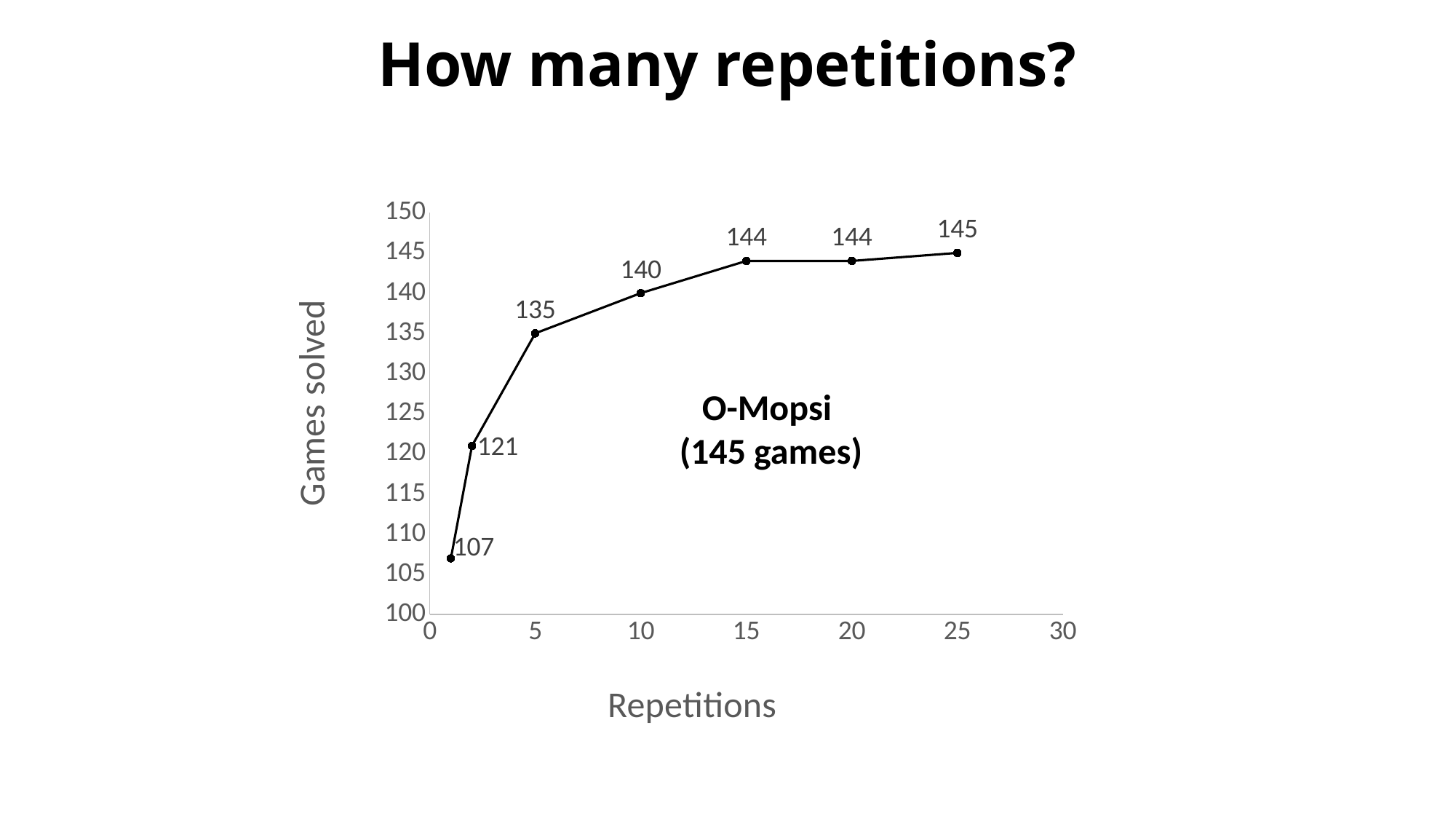
How many data points are plotted on the chart? 7 How many games were solved at 5 repetitions? 135 At which number of repetitions is the number of games solved lowest? 1 How many games were solved at 25 repetitions? 145 Which has more games solved: 2 repetitions or 10 repetitions? 10 repetitions What is the label on the y axis of the chart? Games solved How many games were solved at 10 repetitions? 140 At which number of repetitions is the number of games solved highest? 25 What is the value of the first plotted point, at 1 repetition? 107 What kind of chart is shown on the slide? Line chart What is the difference in games solved between 5 repetitions and 1 repetition? 28 Do the values rise or fall as the number of repetitions increases? Rise